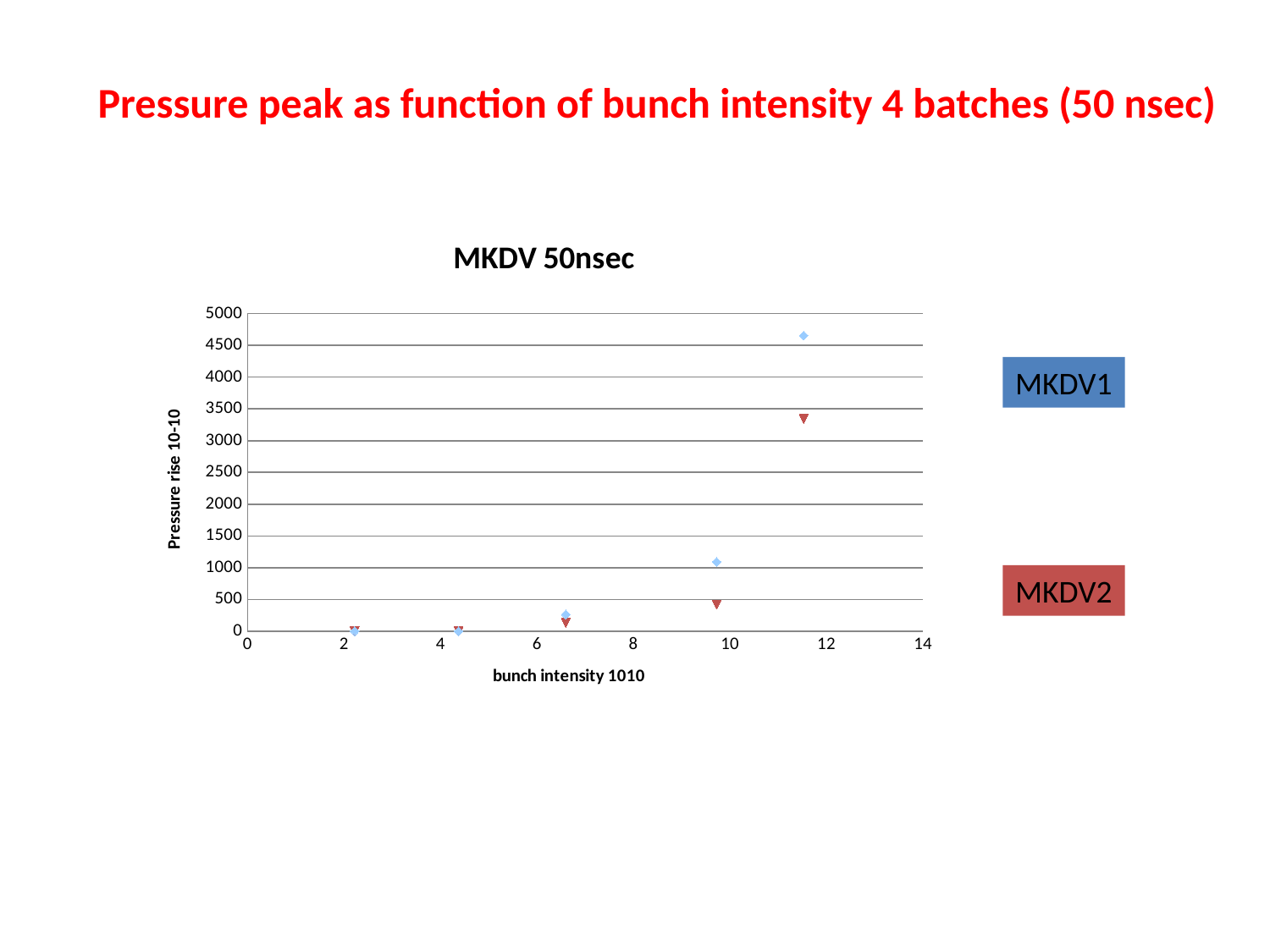
Is the MKDV2 value at a bunch intensity of about 10 greater or less than 1000? less Do the pressure rise values rise or fall as bunch intensity increases? rise How many series are plotted in the MKDV 50nsec chart? 2 How many data points are plotted for the MKDV1 series? 5 What is the label of the x axis? bunch intensity 1010 Is the highest MKDV1 value greater or less than 4500? greater Is the MKDV1 value at a bunch intensity of about 10 greater or less than 500? greater At the highest bunch intensity plotted, which series has the larger pressure rise, MKDV1 or MKDV2? MKDV1 Which series reaches the highest pressure rise in the chart? MKDV1 What is the title of the chart? MKDV 50nsec What kind of chart is shown on the slide? scatter chart